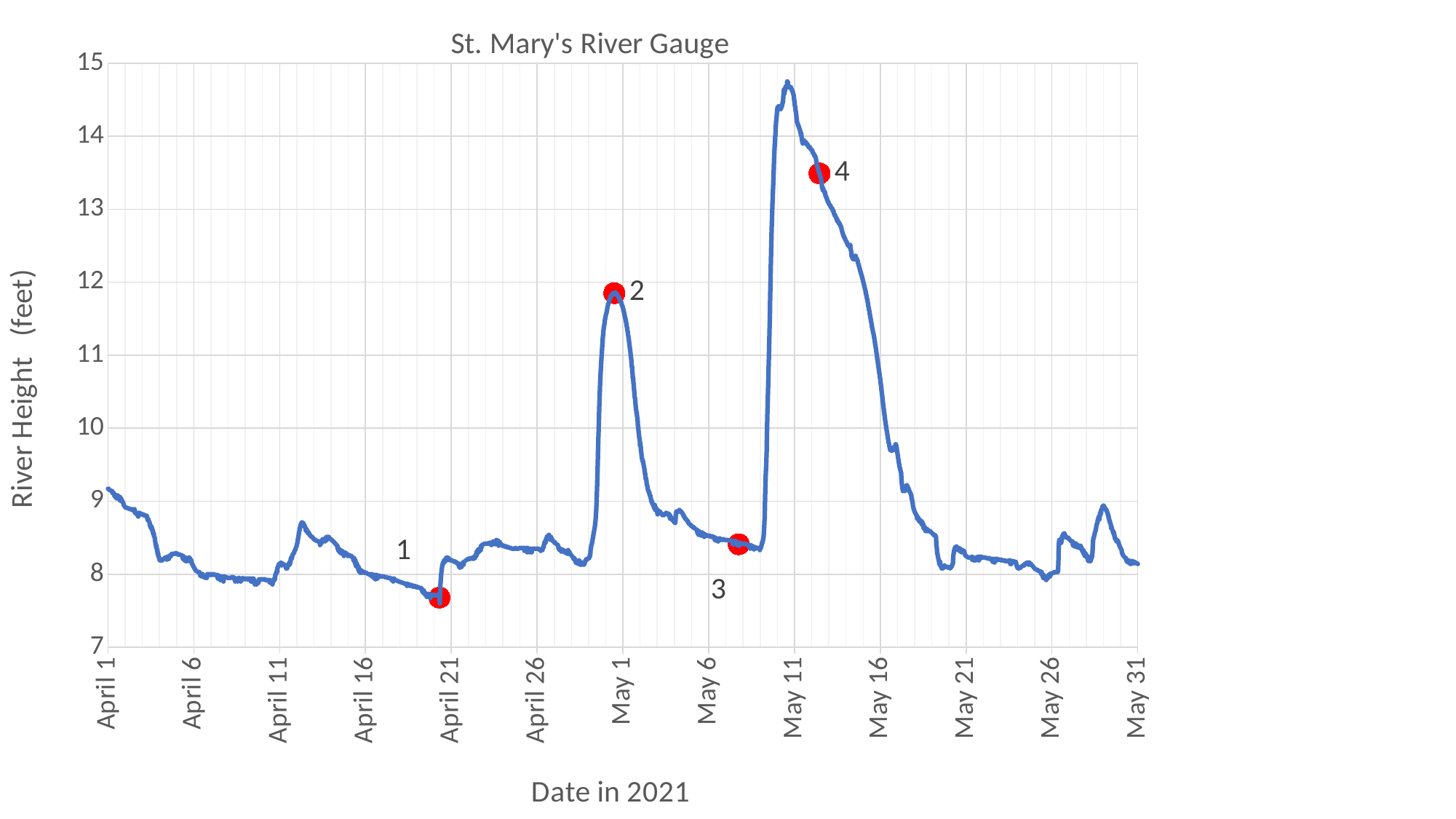
What is the title of the chart? St. Mary's River Gauge Is the river height at marked point 3 greater or less than 9 feet? less Is the river height at marked point 2 greater or less than 11 feet? greater Which of the marked points, 2 or 4, has the higher river height? 4 How many red numbered points are marked on the line? 4 Between May 11 and May 21, does the river height rise or fall? fall Is the river height at marked point 1 greater or less than 8 feet? less What is the label on the vertical axis of the chart? River Height (feet) What kind of chart is shown on the slide? line chart Which marked point has the lowest river height? 1